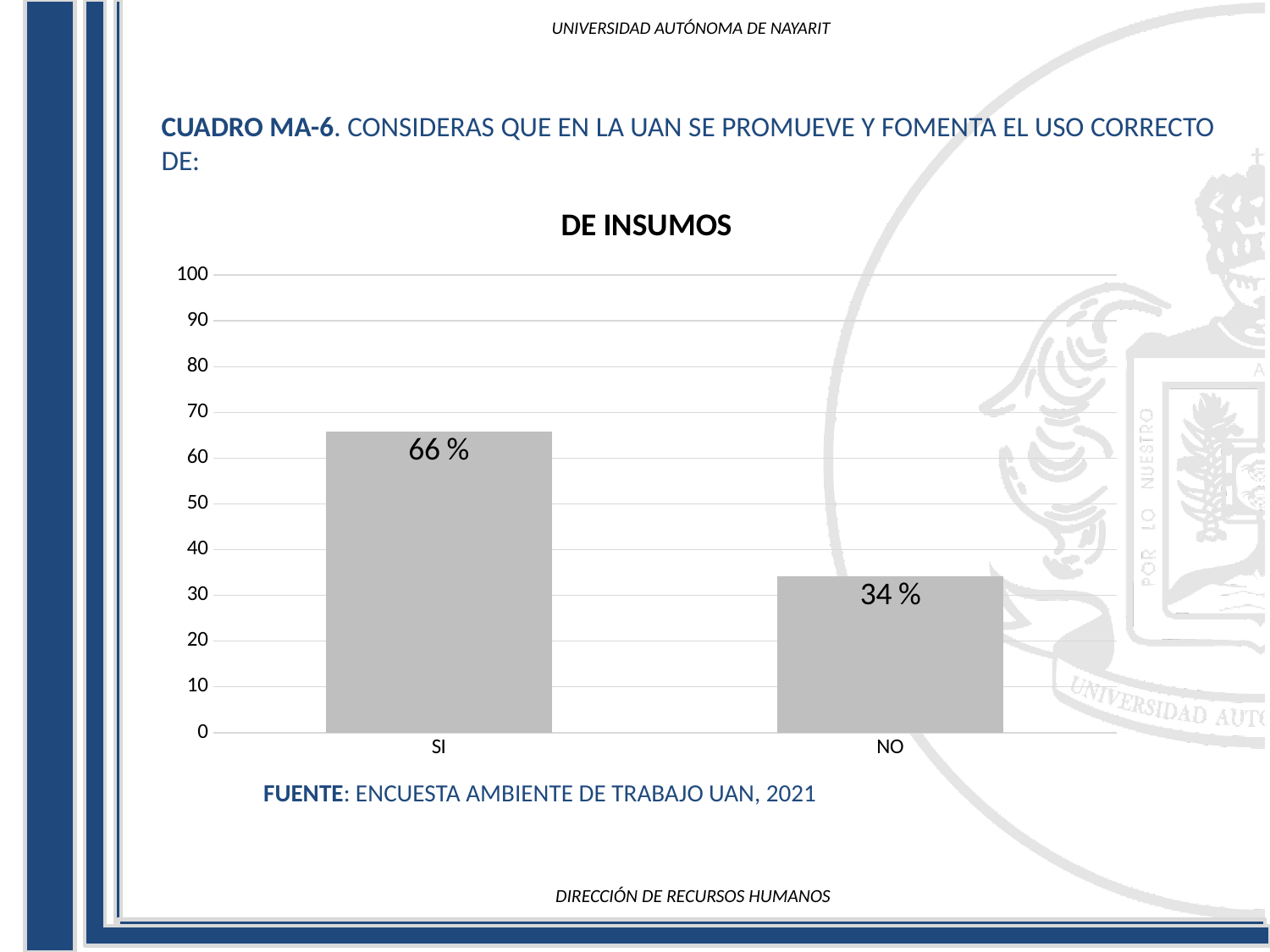
Which category has the lowest value? NO Is the value for NO greater or less than 40? less What is the highest value shown on the y axis? 100 Which is larger, the value for SI or the value for NO? SI What is the value for SI? 66 % Which category has the highest value? SI What is the value for NO? 34 % What is the difference between the values for SI and NO? 32 % How many categories are shown on the x axis? 2 What is the title of the chart? DE INSUMOS What kind of chart is shown? bar chart Is the value for SI greater or less than 50? greater